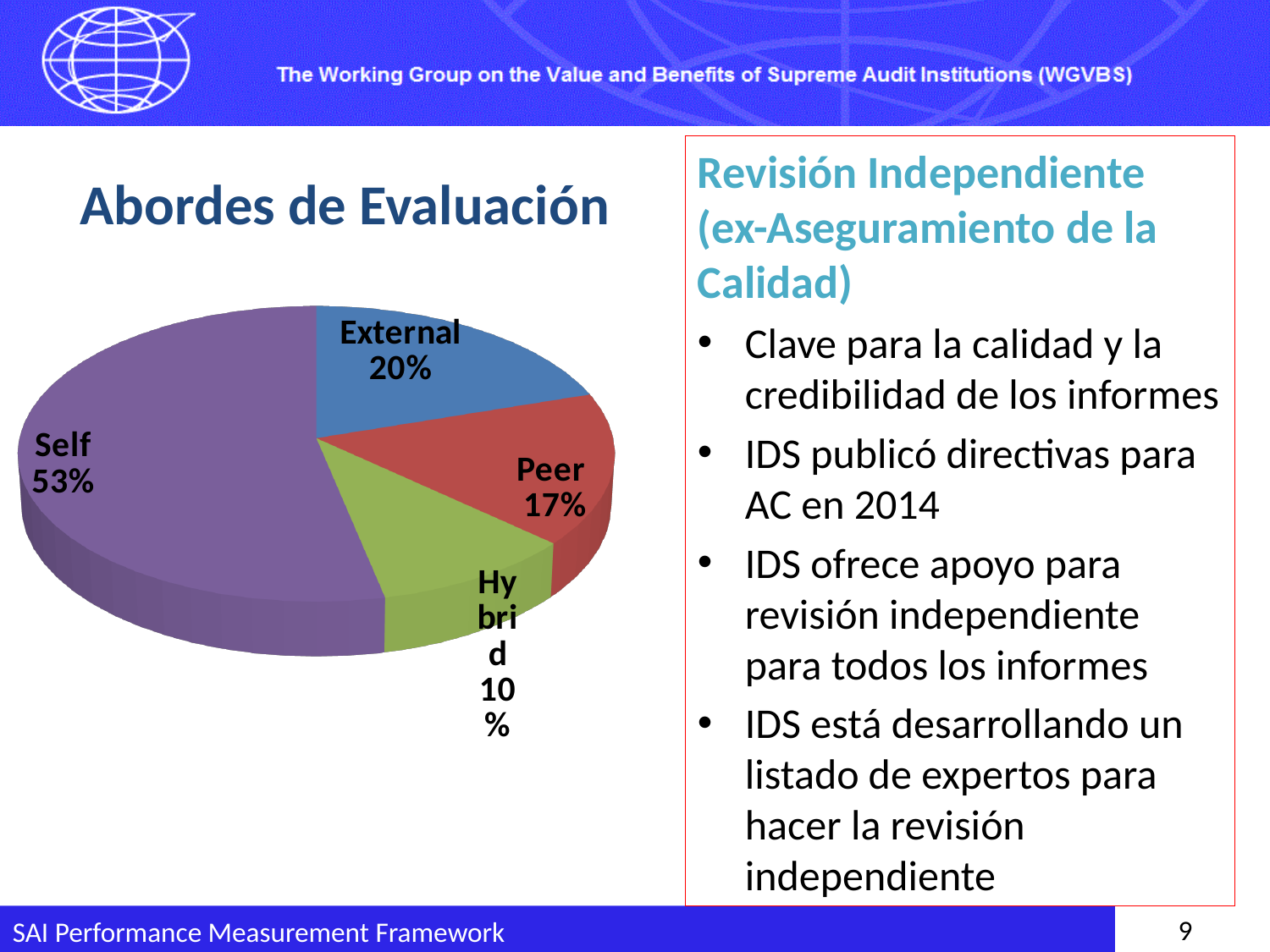
Which slice is larger, External or Peer? External Which category has the smallest slice of the pie? Hybrid What share of the pie does the Hybrid slice represent? 10% Which category has the largest slice of the pie? Self What share of the pie does the Peer slice represent? 17% What is the difference in percentage points between the Self and External slices? 33 What is the difference in percentage points between the Peer and Hybrid slices? 7 What is the title of the chart? Abordes de Evaluación What share of the pie does the Self slice represent? 53% What share of the pie does the External slice represent? 20% What kind of chart is shown on the slide? Pie chart How many slices does the pie chart have? 4